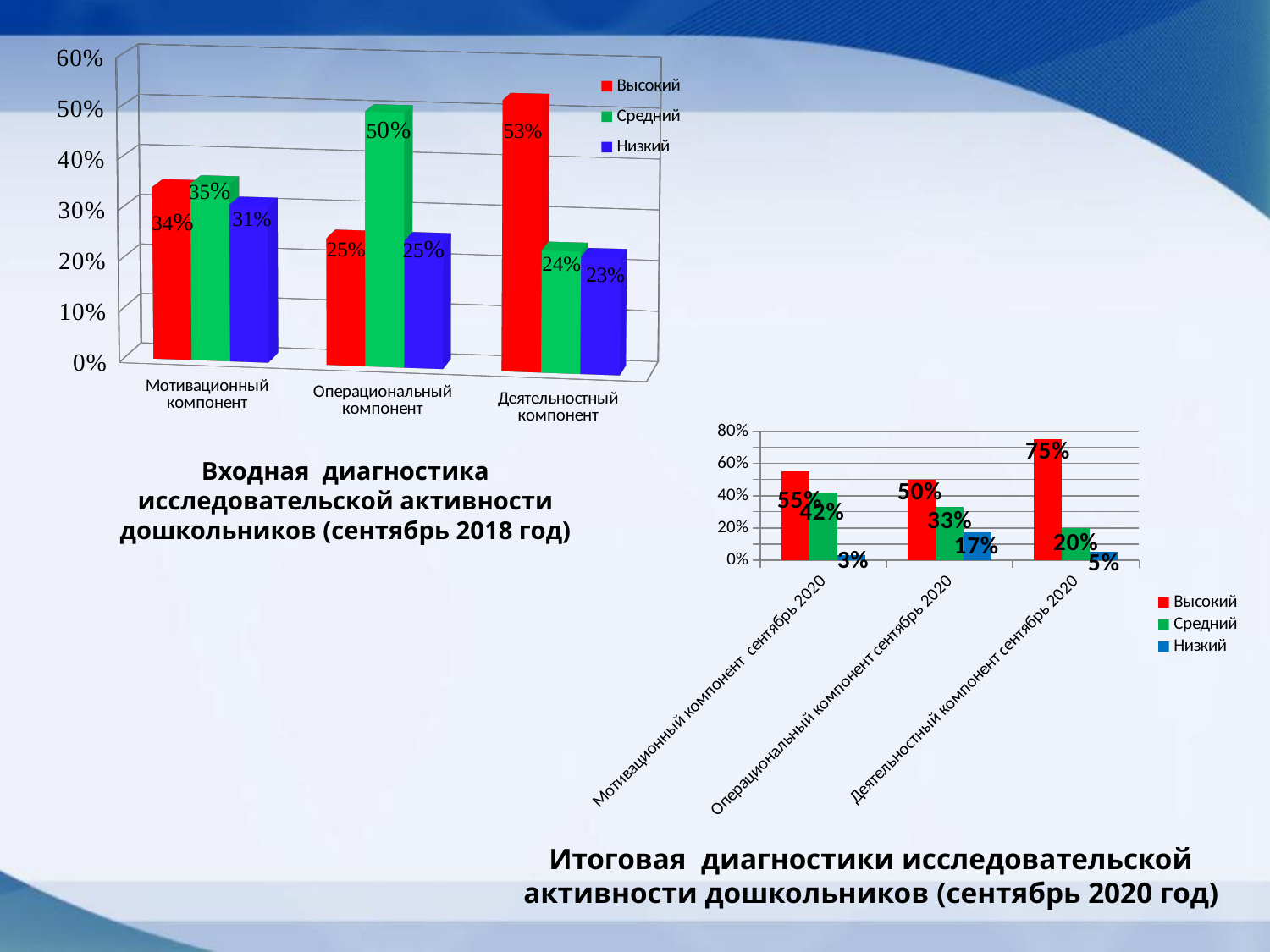
In the bottom-right chart (September 2020), what is the difference between the Высокий and Средний values for the Деятельностный компонент category? 55% In the bottom-right chart (September 2020), which is larger: the Средний value for Мотивационный компонент or the Средний value for Операциональный компонент? Мотивационный компонент In the bottom-right chart (September 2020), what is the value for Высокий in the Деятельностный компонент category? 75% In the top-left chart (September 2018), which category has the highest Высокий value? Деятельностный компонент In the top-left chart (September 2018), what is the value for Средний in the Операциональный компонент category? 50% In the bottom-right chart (September 2020), what is the value for Низкий in the Операциональный компонент category? 17% In the top-left chart (September 2018), what is the difference between the Средний and Низкий values for the Операциональный компонент category? 25% In the bottom-right chart (September 2020), which category has the lowest Низкий value? Мотивационный компонент In the top-left chart (September 2018), what is the value for Высокий in the Деятельностный компонент category? 53% What type of chart is the top-left chart (September 2018)? Bar chart How many series does the legend of the bottom-right chart (September 2020) list? 3 In the top-left chart (September 2018), what is the value for Низкий in the Мотивационный компонент category? 31%